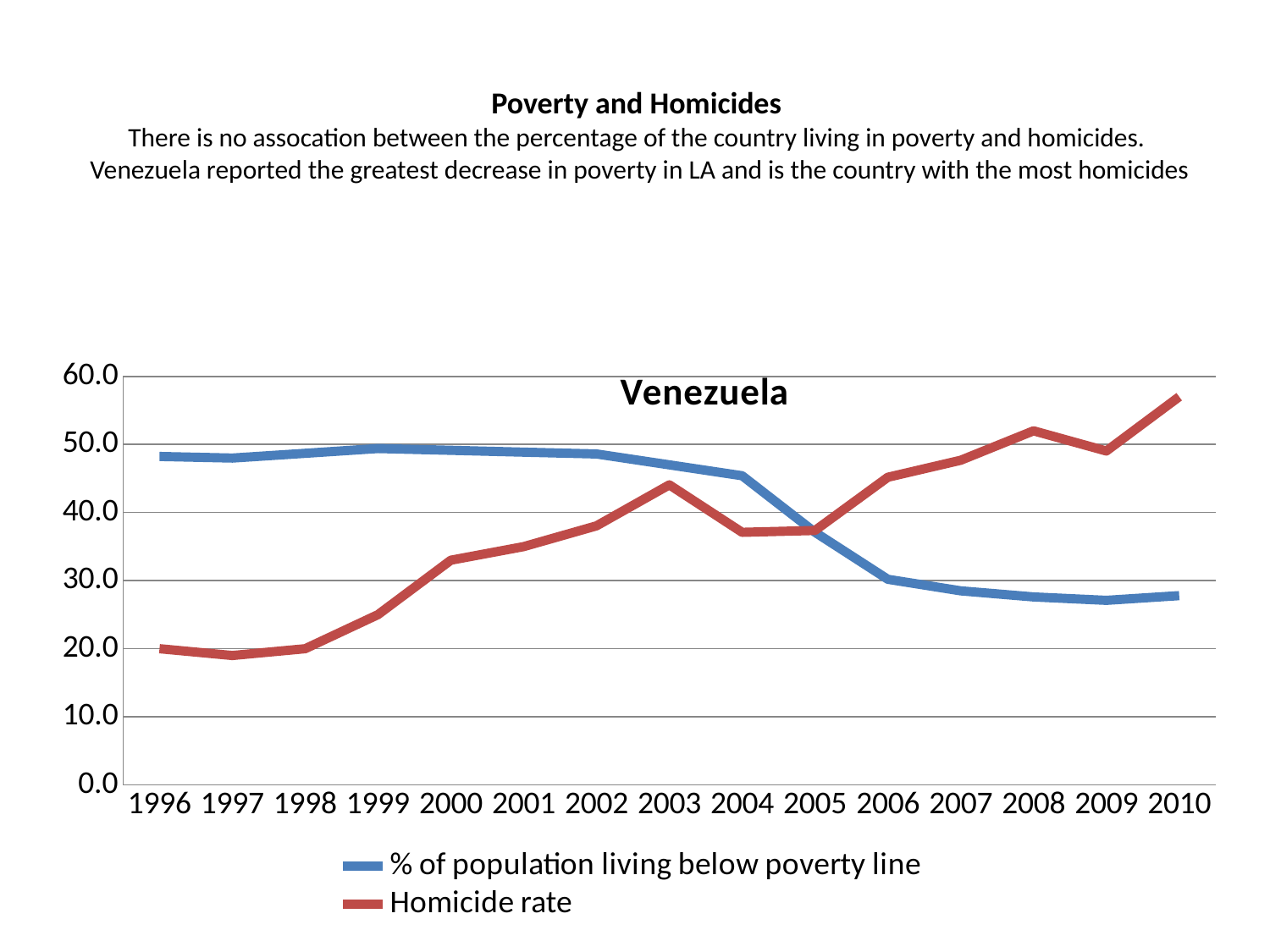
Is the % of population living below poverty line in 2010 greater or less than 30? less What kind of chart is shown on the slide? Line chart How many years are shown on the x axis? 15 Is the Homicide rate in 2010 greater or less than 50? greater Is the % of population living below poverty line in 1996 greater or less than 50? less In 2010, which is larger: the % of population living below poverty line or the Homicide rate? Homicide rate In 1996, which is larger: the % of population living below poverty line or the Homicide rate? % of population living below poverty line Does the % of population living below poverty line generally rise or fall from 1996 to 2010? Fall How many series does the legend list? 2 Which year has the highest Homicide rate? 2010 What is the title of the chart? Venezuela